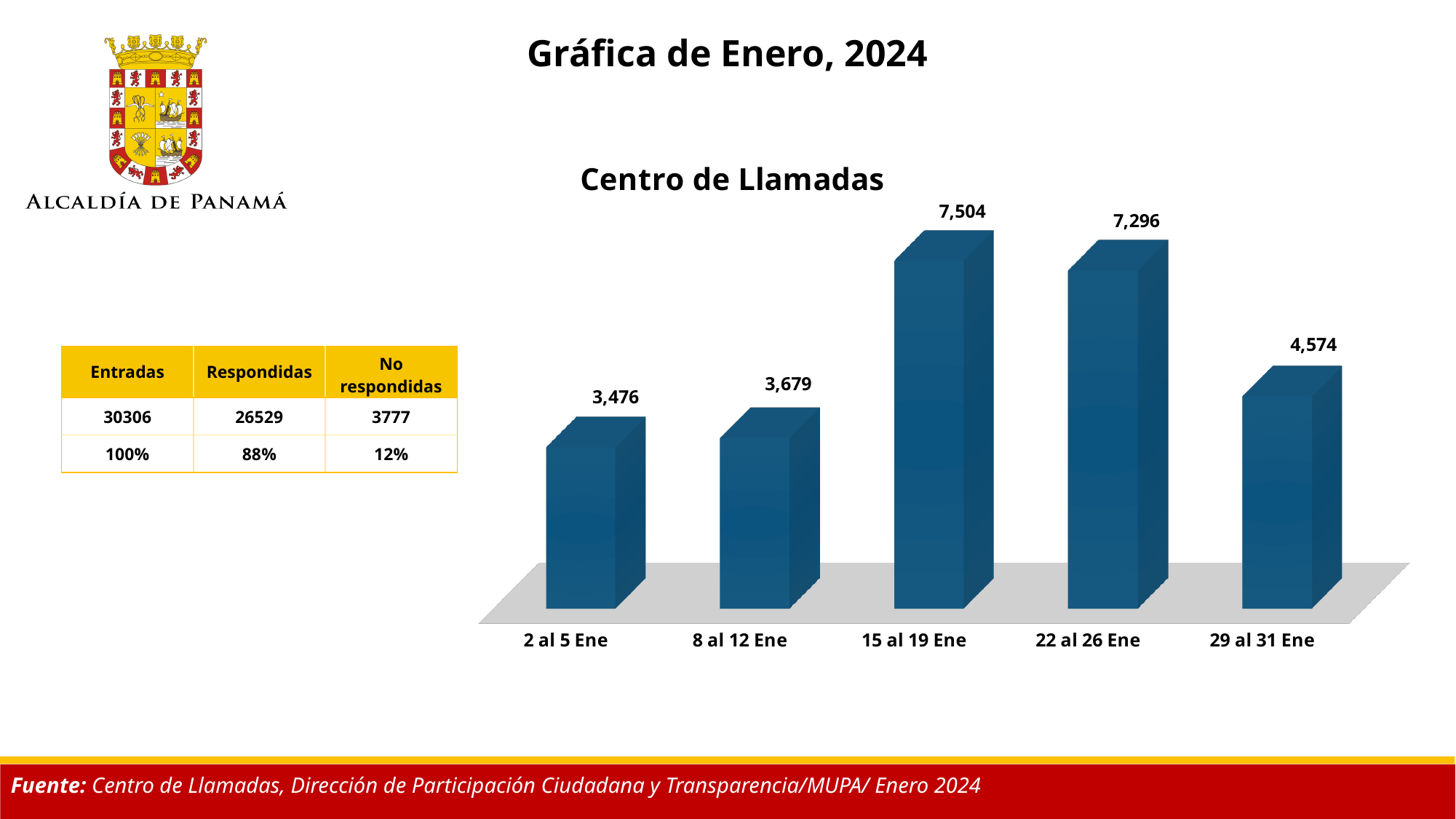
What is the value for 29 al 31 Ene in the Centro de Llamadas chart? 4,574 What is the value for 15 al 19 Ene in the Centro de Llamadas chart? 7,504 What kind of chart is shown on the slide? Bar chart Which is larger, the value for 22 al 26 Ene or the value for 29 al 31 Ene? 22 al 26 Ene What is the value for 2 al 5 Ene in the Centro de Llamadas chart? 3,476 What colour are the bars in the Centro de Llamadas chart? Blue Which category has the highest value in the Centro de Llamadas chart? 15 al 19 Ene Which category has the lowest value in the Centro de Llamadas chart? 2 al 5 Ene How many categories are shown on the x axis of the Centro de Llamadas chart? 5 What is the difference between the values for 8 al 12 Ene and 2 al 5 Ene? 203 What is the difference between the values for 15 al 19 Ene and 22 al 26 Ene? 208 What is the title of the chart? Centro de Llamadas